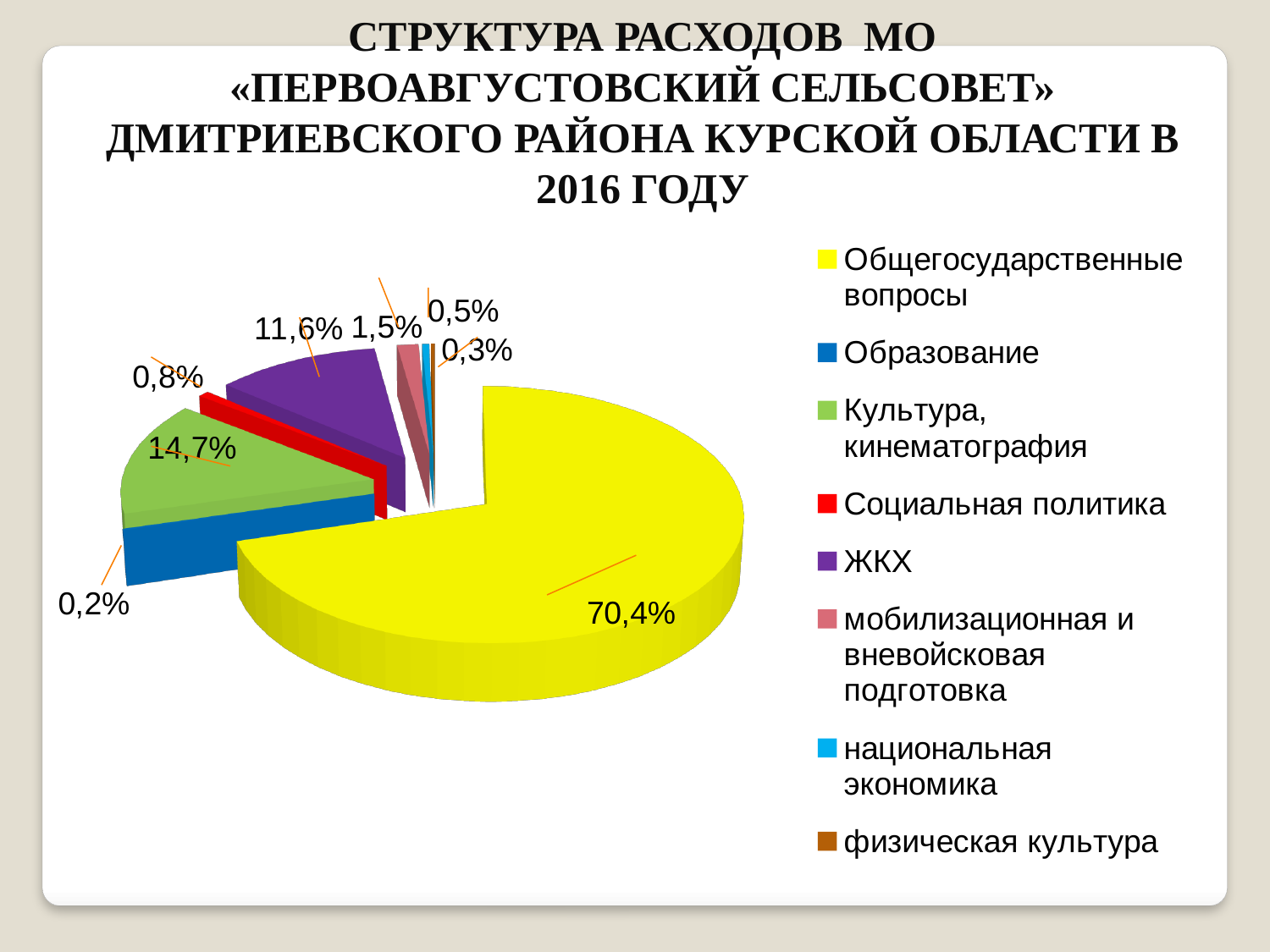
What share of expenditures is Общегосударственные вопросы? 70,4% What share of expenditures is Социальная политика? 0,8% Which category has the smallest share of expenditures? Образование What share of expenditures is Культура, кинематография? 14,7% What is the difference between the shares of Культура, кинематография and ЖКХ? 3,1% Which is larger: the share of ЖКХ or the share of Культура, кинематография? Культура, кинематография How many categories does the legend list? 8 What type of chart is shown on the slide? pie chart What share of expenditures is ЖКХ? 11,6% What share of expenditures is мобилизационная и вневойсковая подготовка? 1,5% What share of expenditures is национальная экономика? 0,5% Which category has the largest share of expenditures? Общегосударственные вопросы